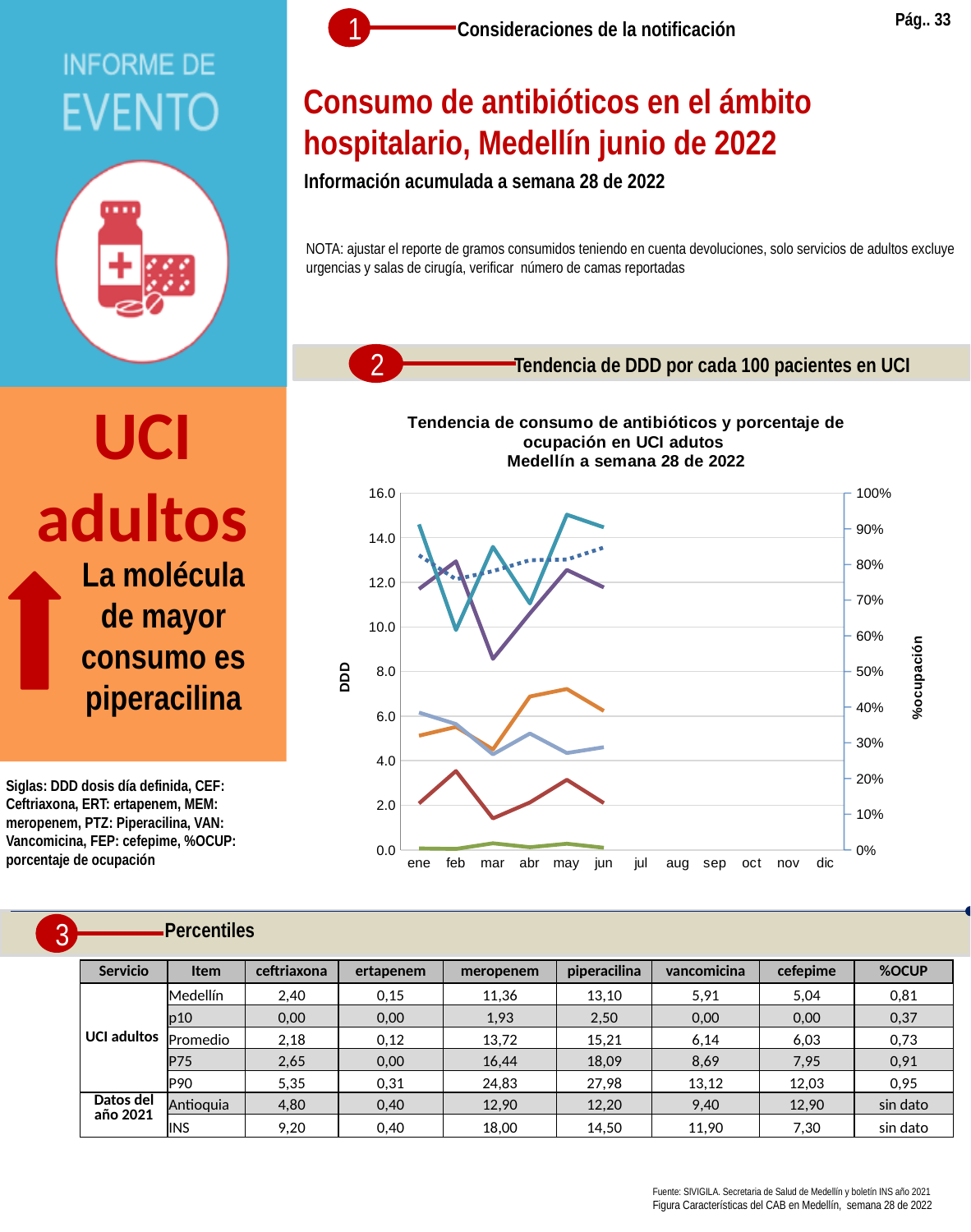
Is the value of the green line in mar greater or less than 2.0? less What kind of chart is shown on the slide? line chart What is the title of the right-hand vertical axis of the chart? %ocupación Is the value of the teal line in may greater or less than 14.0? greater For how many months are data points actually plotted on the chart? 6 In which month does the purple line reach its lowest value? mar Is the value of the orange line in may greater or less than 6.0? greater How many months are labelled along the x axis of the chart? 12 Does the orange line rise or fall from mar to may? rises In which month does the teal line reach its highest value? may What is the title of the chart? Tendencia de consumo de antibióticos y porcentaje de ocupación en UCI adutos Medellín a semana 28 de 2022